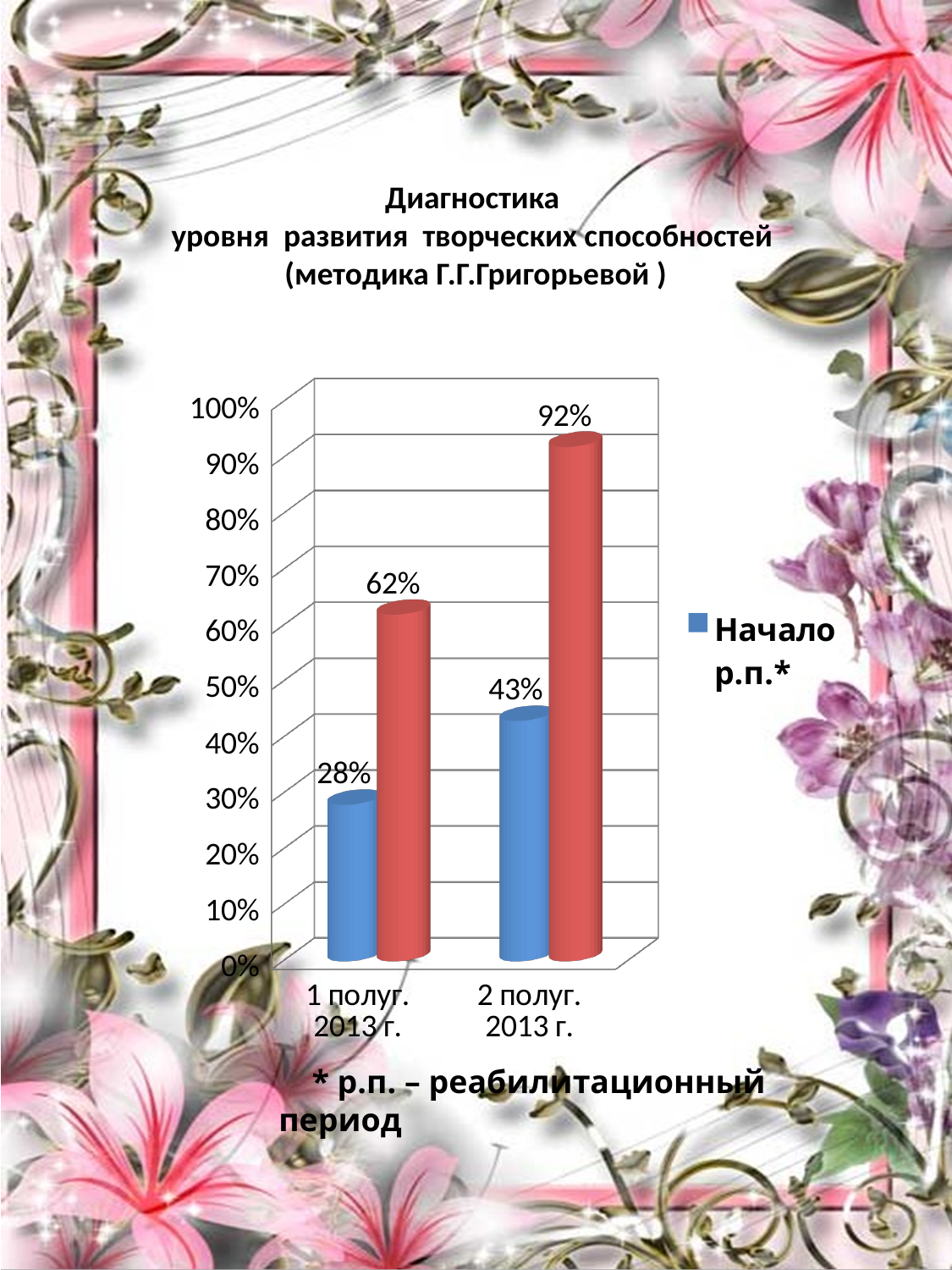
What is the value of the red bar for 2 полуг. 2013 г.? 92% How many categories are shown on the x axis? 2 What kind of chart is shown on the slide? bar chart Which bar is the lowest on the chart? Начало р.п.* for 1 полуг. 2013 г. (28%) What is the value of the Начало р.п.* series for 2 полуг. 2013 г.? 43% For 1 полуг. 2013 г., which is larger: the blue bar or the red bar? the red bar Which category has the higher value for the Начало р.п.* series? 2 полуг. 2013 г. What is the difference between the red bar values for 2 полуг. 2013 г. and 1 полуг. 2013 г.? 30% What is the value of the red bar for 1 полуг. 2013 г.? 62% What is the value of the Начало р.п.* series for 1 полуг. 2013 г.? 28% Does the Начало р.п.* series rise or fall from 1 полуг. 2013 г. to 2 полуг. 2013 г.? rise By how much does the Начало р.п.* value for 2 полуг. 2013 г. exceed that for 1 полуг. 2013 г.? 15%